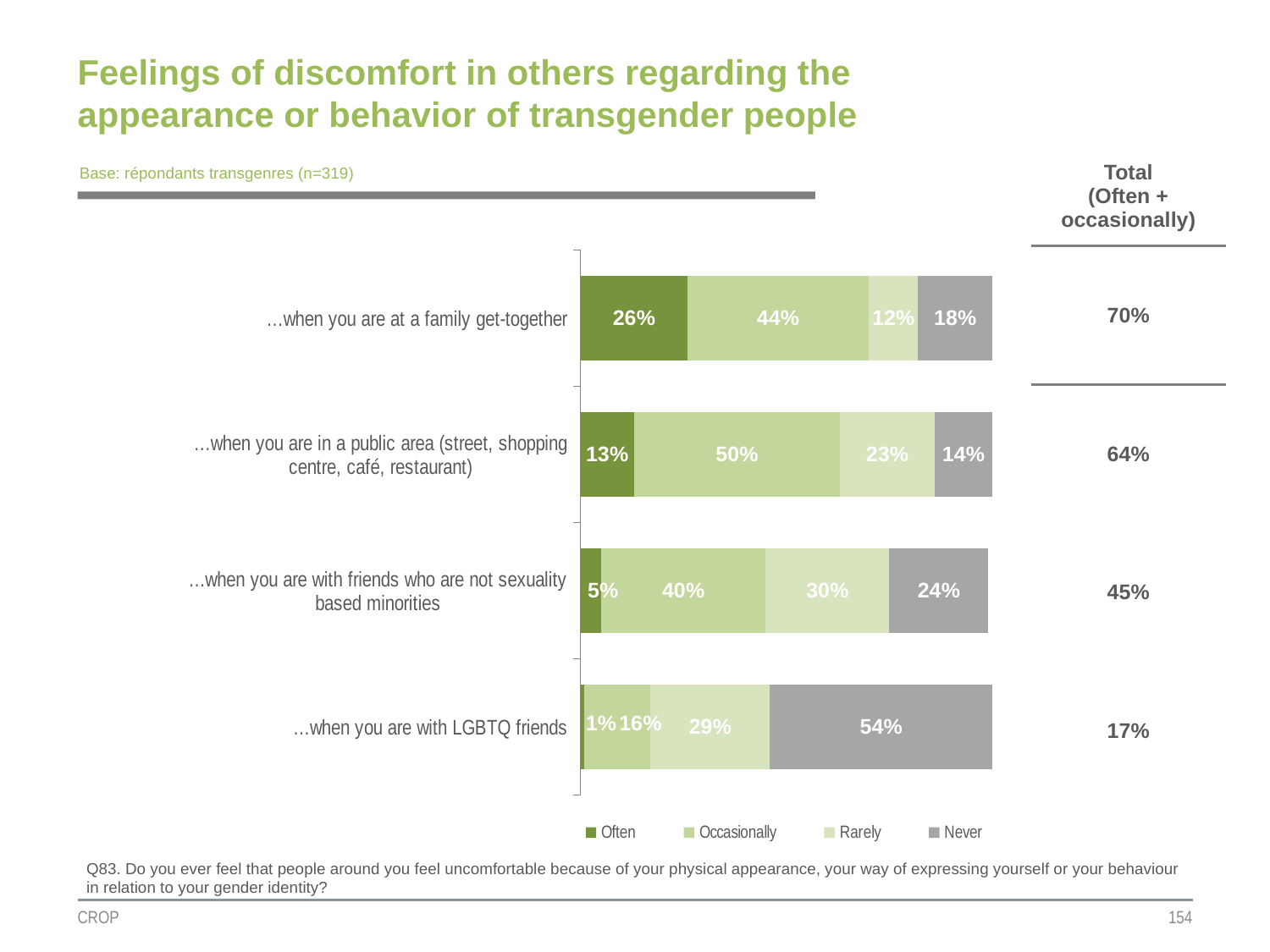
How many situations (categories) are shown in the chart? 4 What kind of chart is shown on the slide? Stacked bar chart Is the 'Occasionally' percentage larger for a family get-together or for being with LGBTQ friends? …when you are at a family get-together What percentage answered 'Occasionally' for when they are in a public area (street, shopping centre, café, restaurant)? 50% What is the difference between the 'Never' percentages for when with LGBTQ friends and when at a family get-together? 36% What percentage answered 'Never' for when they are with LGBTQ friends? 54% What percentage of respondents answered 'Often' for when they are at a family get-together? 26% Which situation has the highest 'Often' percentage? …when you are at a family get-together How many series does the legend list? 4 Which situation has the lowest 'Never' percentage? …when you are in a public area (street, shopping centre, café, restaurant) What percentage answered 'Rarely' for when they are with friends who are not sexuality based minorities? 30% What is the Total (Often + occasionally) shown for when you are with friends who are not sexuality based minorities? 45%